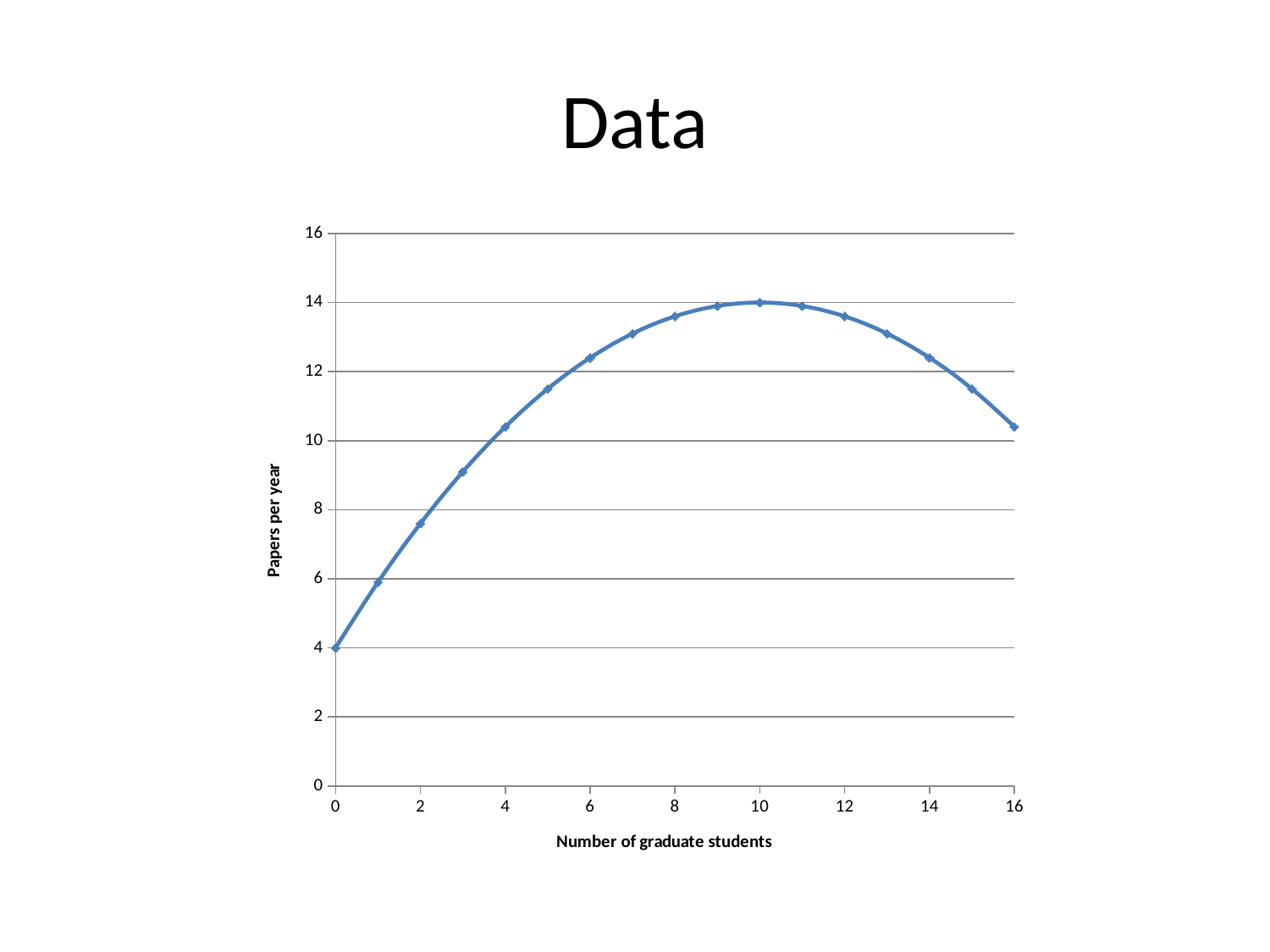
At which number of graduate students is papers per year lowest? 0 What is the value of papers per year when the number of graduate students is 10? 14 At which number of graduate students is papers per year highest? 10 How many data points are plotted on the chart? 17 Is the value for 6 graduate students greater or less than 12? greater Is the value for 2 graduate students greater or less than 8? less Is the value for 16 graduate students greater or less than 12? less How do papers per year change as the number of graduate students increases from 0 to 16? rise to a peak at 10, then fall Which has more papers per year: 2 graduate students or 14 graduate students? 14 graduate students What is the label of the x axis? Number of graduate students What is the value of papers per year when the number of graduate students is 0? 4 What kind of chart is shown on the slide? line chart